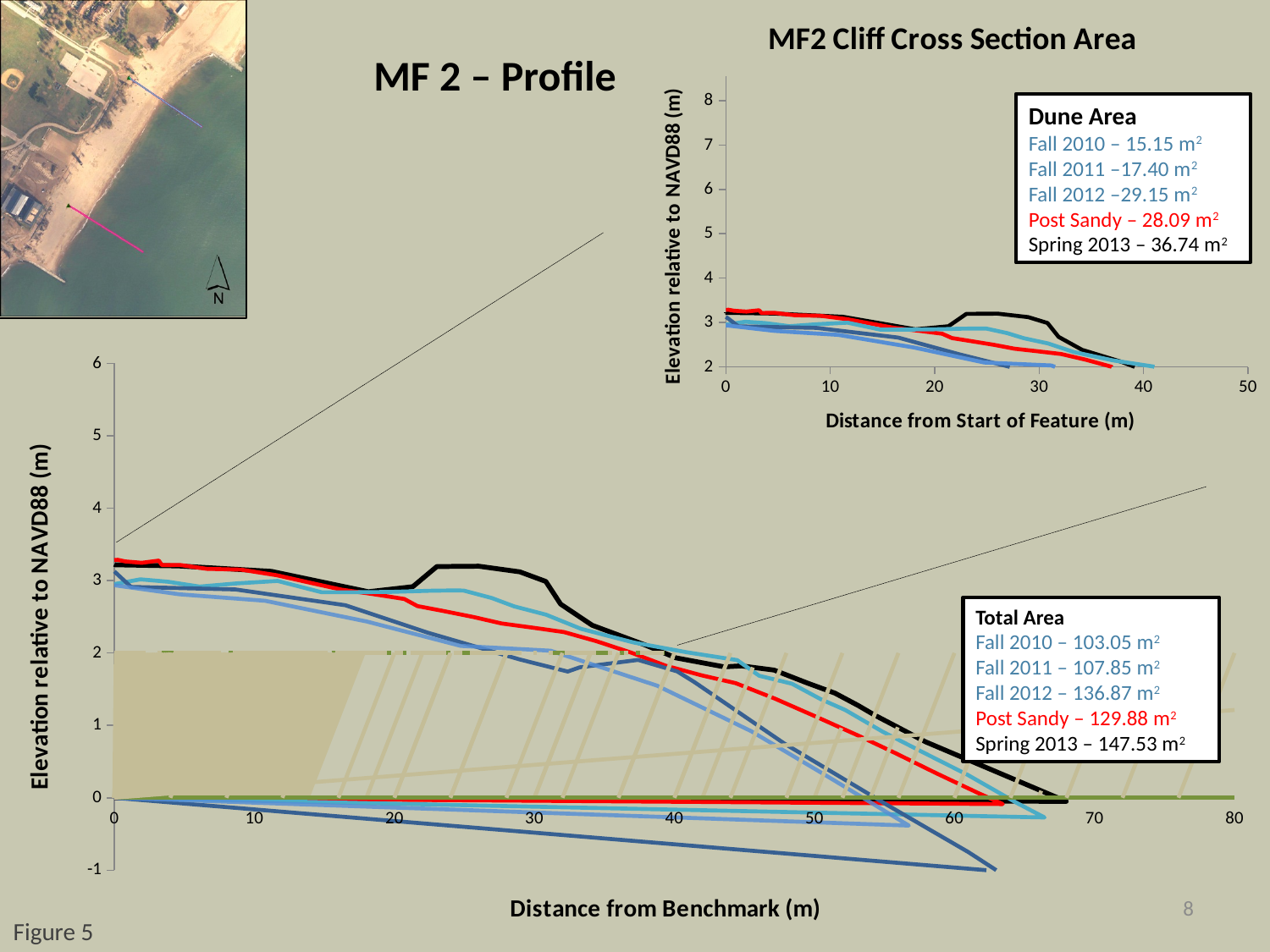
How many surveys are listed in the Total Area box on the MF 2 – Profile chart? 5 On the MF2 Cliff Cross Section Area chart, is the Spring 2013 elevation at distance 0 greater or less than 3? greater On the MF 2 – Profile chart, which survey has the largest Total Area? Spring 2013 On the MF 2 – Profile chart, which has the larger Total Area, Fall 2012 or Post Sandy? Fall 2012 On the MF2 Cliff Cross Section Area chart, what is the Dune Area for Post Sandy? 28.09 m² On the MF2 Cliff Cross Section Area chart, what is the Dune Area for Fall 2012? 29.15 m² What is the x-axis label of the MF 2 – Profile chart? Distance from Benchmark (m) On the MF 2 – Profile chart, what is the Total Area for Spring 2013? 147.53 m² What kind of chart is the MF 2 – Profile chart? Line chart On the MF2 Cliff Cross Section Area chart, which survey has the smallest Dune Area? Fall 2010 On the MF2 Cliff Cross Section Area chart, what is the difference between the Dune Area for Spring 2013 and Fall 2010? 21.59 m² On the MF 2 – Profile chart, what is the difference between the Total Area for Spring 2013 and Fall 2010? 44.48 m²